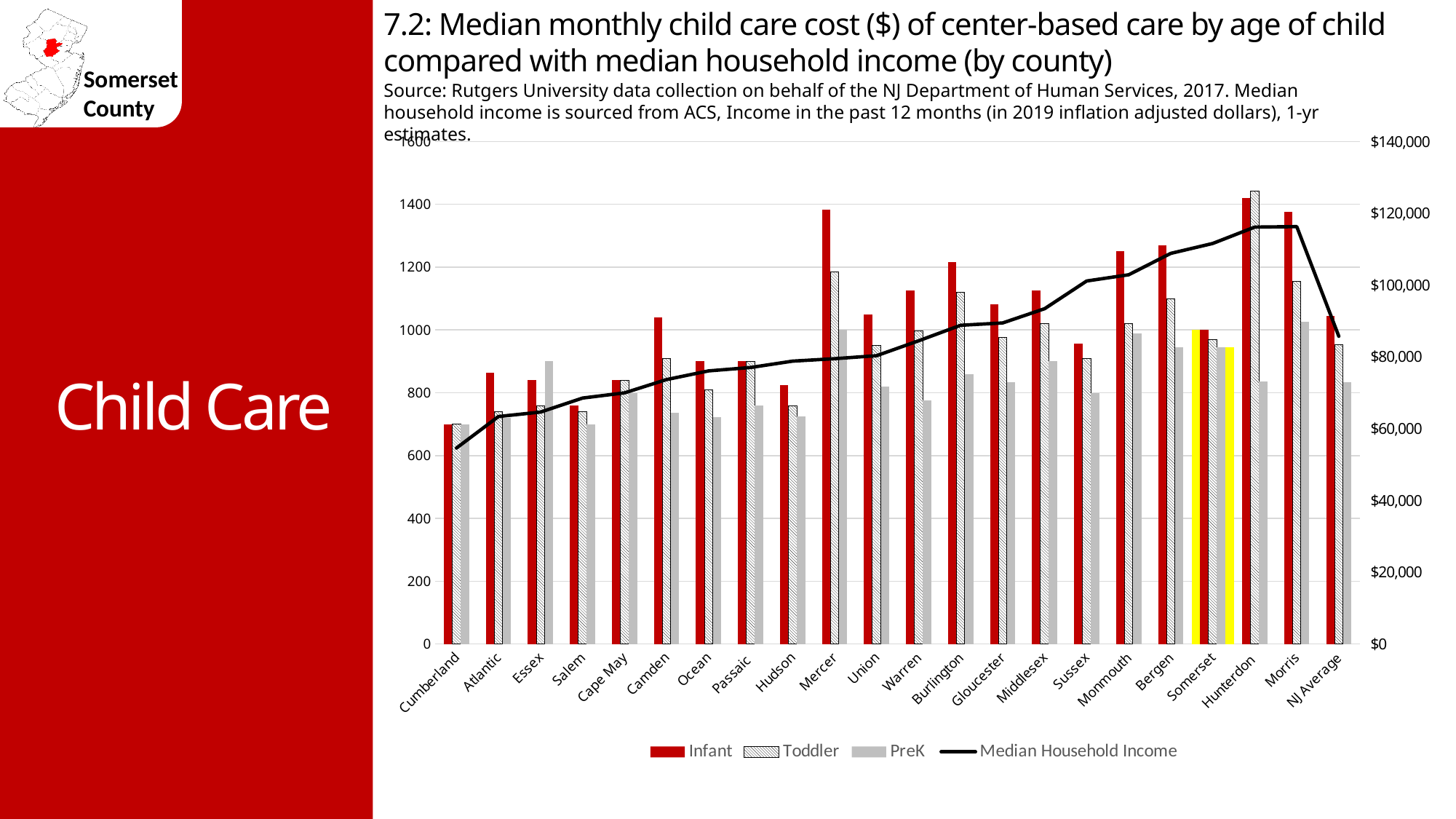
Is the Median Household Income for Morris greater or less than $100,000? greater Is the Infant value for Mercer greater or less than 1200? greater What kind of chart is this? bar chart with a line Which county has the highest Toddler bar? Hunterdon Is the Infant value for Cumberland greater or less than 800? less Which county has the lowest Infant bar? Cumberland How many series does the legend list? 4 Does the Median Household Income line generally rise or fall from Cumberland to Morris? rise How many counties/categories are shown along the x axis? 22 Which is larger, the Infant value for Mercer or the Infant value for Camden? Mercer Which county's bars are highlighted in yellow? Somerset Which county has the highest Infant bar? Hunterdon